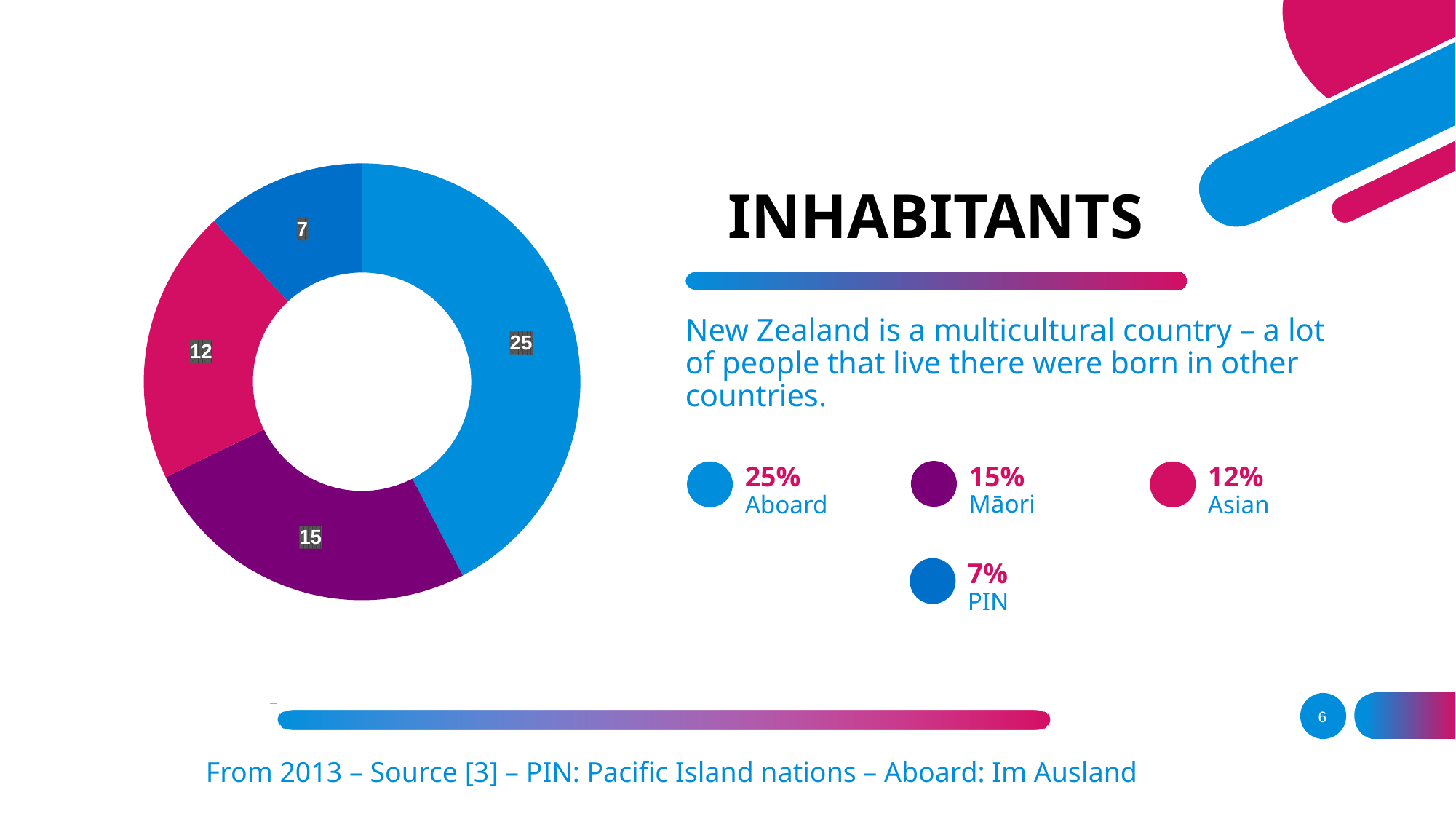
Which category has the smallest slice in the chart? PIN What value is labelled on the Asian slice of the chart? 12 What value is labelled on the Māori slice of the chart? 15 What is the title of the slide containing the chart? INHABITANTS Which category has the largest slice in the chart? Aboard What value is labelled on the Aboard slice of the chart? 25 What is the difference between the Aboard value and the Māori value? 10 What percentage does the legend show for Asian? 12% How many slices does the chart have? 4 What type of chart is shown on the slide? Doughnut chart What value is labelled on the PIN slice of the chart? 7 Which is larger, the Asian slice or the PIN slice? Asian